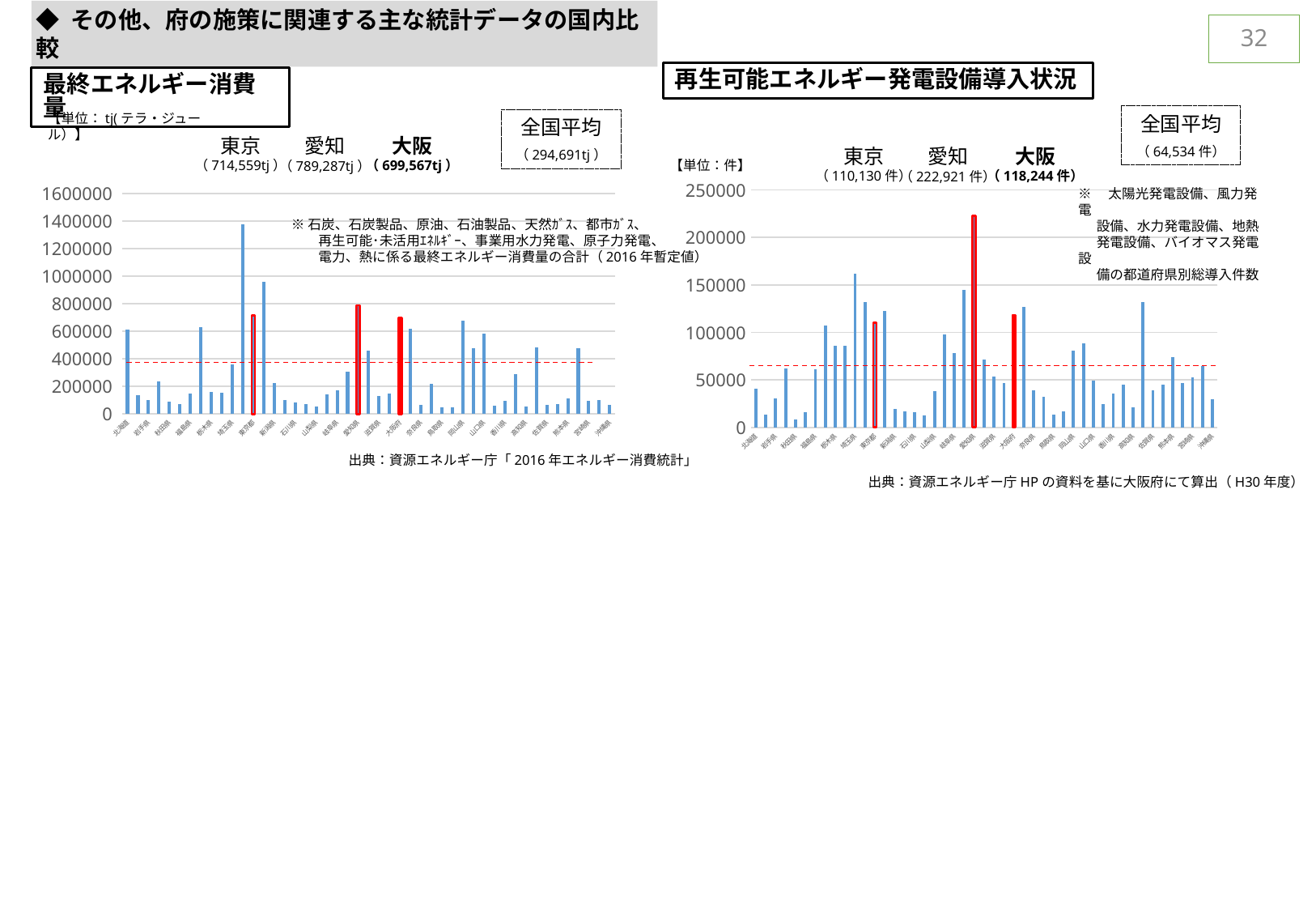
In the 再生可能エネルギー発電設備導入状況 chart on the right, what is the difference between the values for 愛知 and 大阪? 104,677 件 In the 最終エネルギー消費量 chart on the left, what is the value printed for 愛知? 789,287tj In the 最終エネルギー消費量 chart on the left, is the value for 大阪 greater or less than 600000? greater In the 再生可能エネルギー発電設備導入状況 chart on the right, what is the value printed for 愛知? 222,921 件 In the 最終エネルギー消費量 chart on the left, what is the value printed for 大阪? 699,567tj In the 最終エネルギー消費量 chart on the left, what is the difference between the values for 愛知 and 大阪? 89,720tj In the 再生可能エネルギー発電設備導入状況 chart on the right, what is the value printed for 大阪? 118,244 件 In the 最終エネルギー消費量 chart on the left, which of the three labeled prefectures 東京, 愛知 and 大阪 has the highest value? 愛知 In the 再生可能エネルギー発電設備導入状況 chart on the right, what is the 全国平均 (national average) shown? 64,534 件 What kind of chart is the 再生可能エネルギー発電設備導入状況 chart on the right? bar chart In the 再生可能エネルギー発電設備導入状況 chart on the right, which has the larger value, 東京 or 大阪? 大阪 In the 最終エネルギー消費量 chart on the left, what is the 全国平均 (national average) shown? 294,691tj